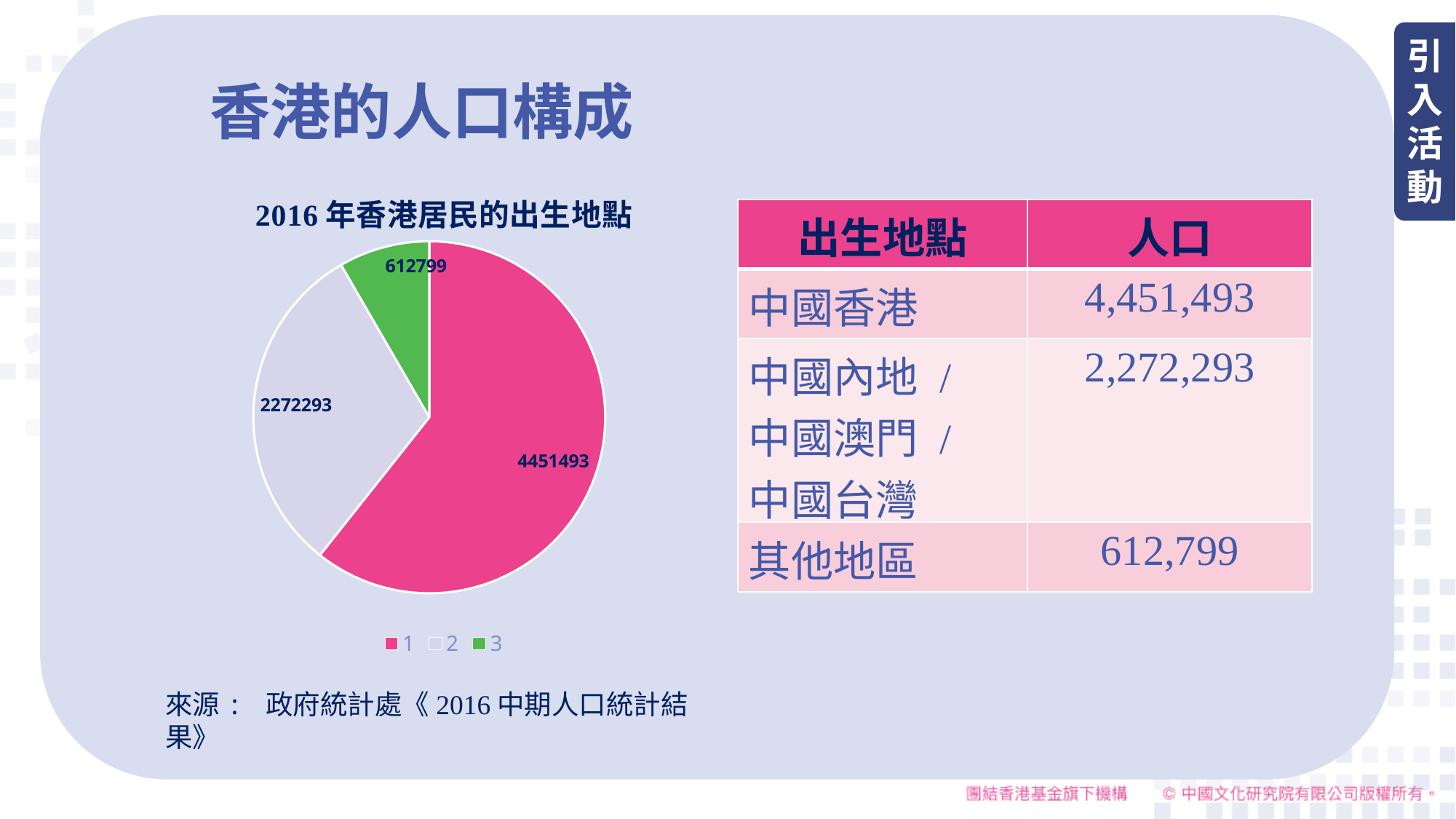
How many slices does the pie chart have? 3 Which slice of the pie chart has the largest value? 1 What value is labelled on slice 2 of the pie chart? 2272293 What colour is slice 3 in the pie chart? green What kind of chart is shown on the slide? pie chart Which slice of the pie chart has the smallest value? 3 What value is labelled on slice 3 of the pie chart? 612799 What is the difference between the values of slice 1 and slice 2 in the pie chart? 2179200 What value is labelled on slice 1 of the pie chart? 4451493 What is the title of the pie chart? 2016 年香港居民的出生地點 How many entries does the pie chart's legend list? 3 Which is larger in the pie chart, slice 2 or slice 3? 2